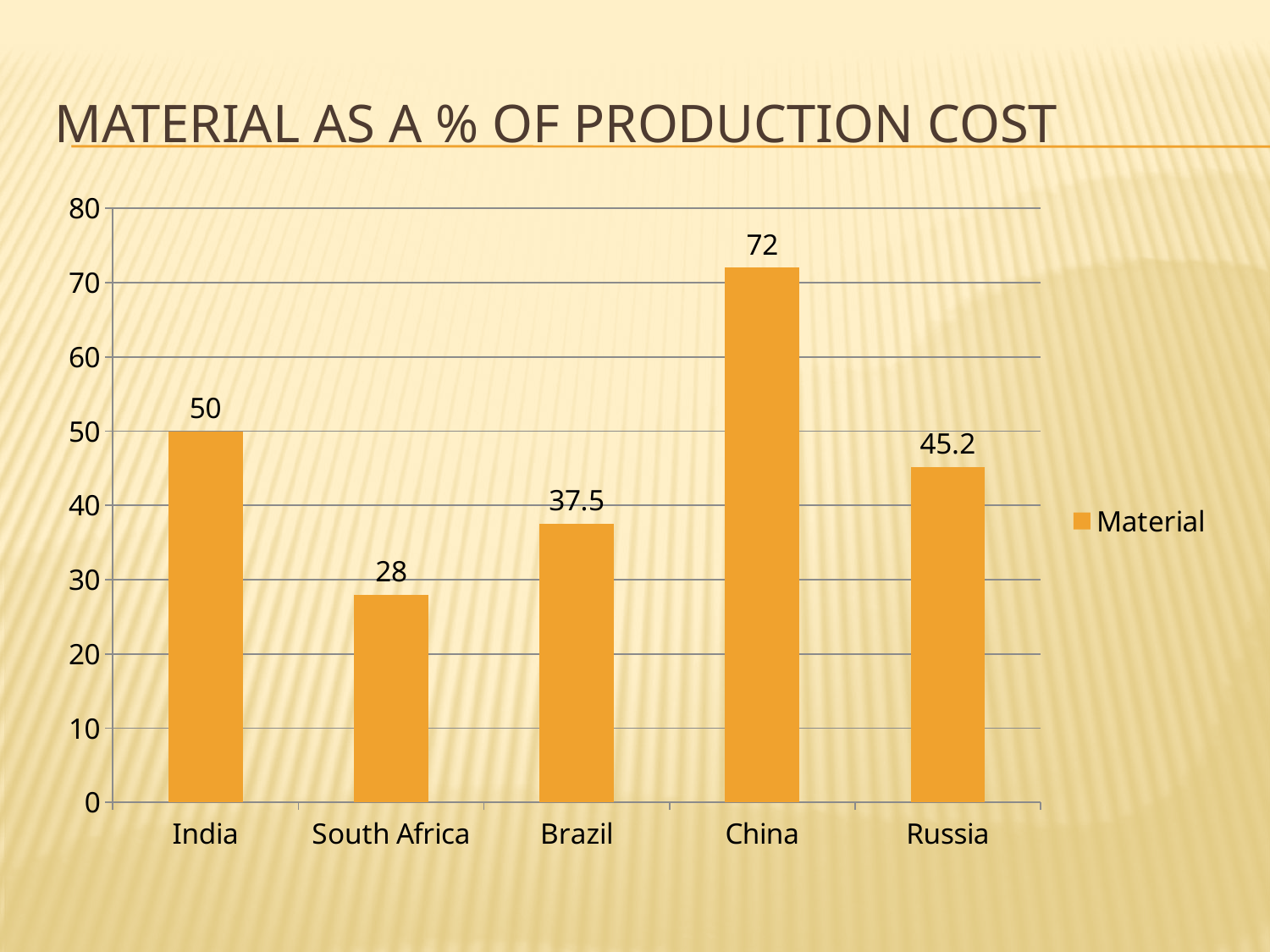
How many countries are shown on the chart? 5 What kind of chart is shown on the slide? bar chart What is the difference between the values for Russia and South Africa? 17.2 Which country has the highest value? China What is the difference between the values for China and India? 22 Which country has the lowest value? South Africa What is the value for Russia? 45.2 Is the value for China greater or less than 70? greater Which is larger, the value for Brazil or the value for Russia? Russia What is the title of the chart? Material as a % of Production Cost What is the value for India? 50 What is the value for Brazil? 37.5